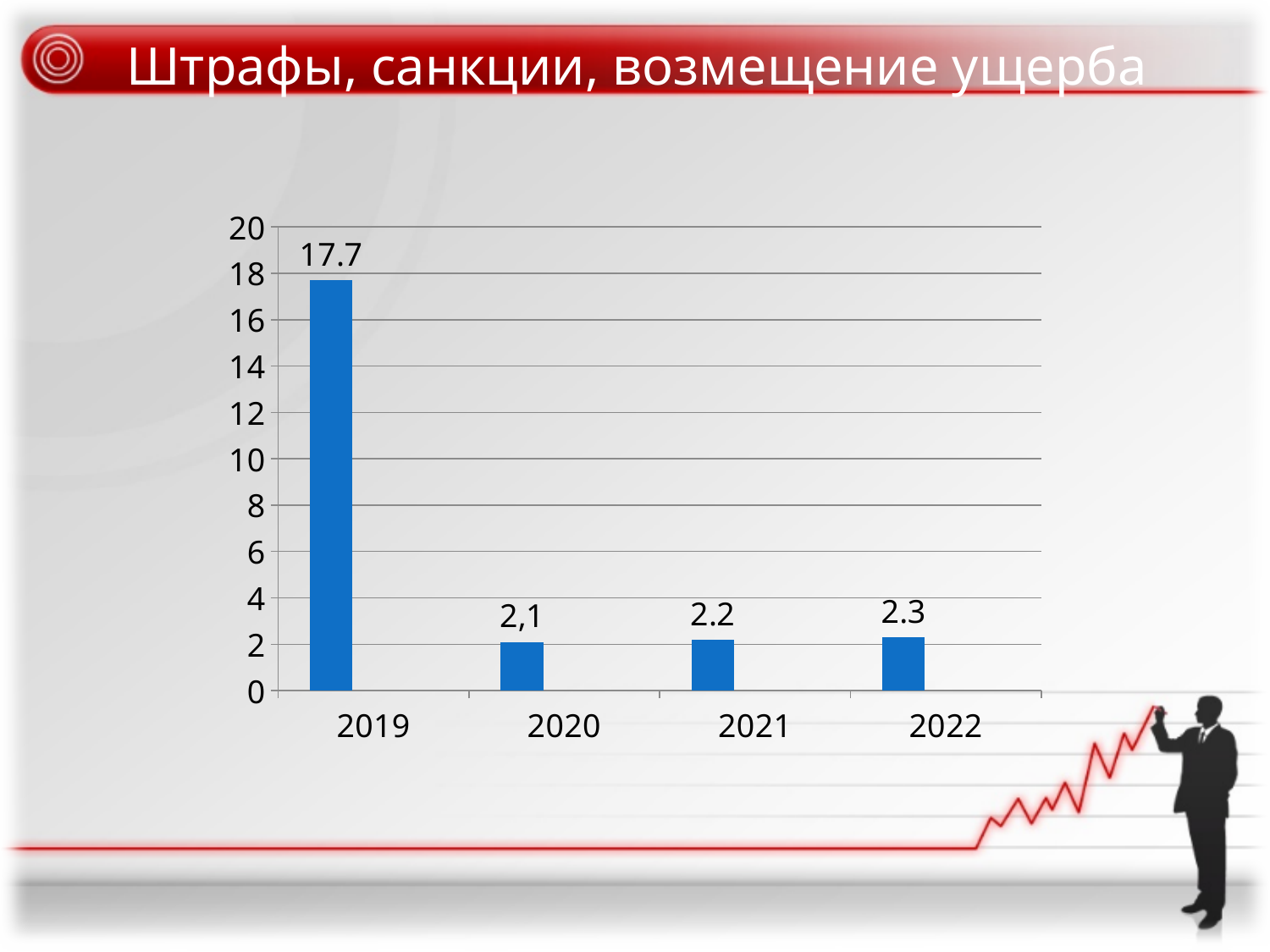
What kind of chart is shown on the slide? bar chart What is the value for 2020? 2,1 What is the value for 2019? 17.7 Which year has the highest value? 2019 What is the title of the slide? Штрафы, санкции, возмещение ущерба Which year has the lowest value? 2020 How many years are shown on the x axis? 4 What is the difference between the values for 2019 and 2022? 15.4 What is the value for 2021? 2.2 Which is larger, the value for 2019 or the value for 2020? 2019 Is the value for 2019 greater or less than 10? greater What is the value for 2022? 2.3